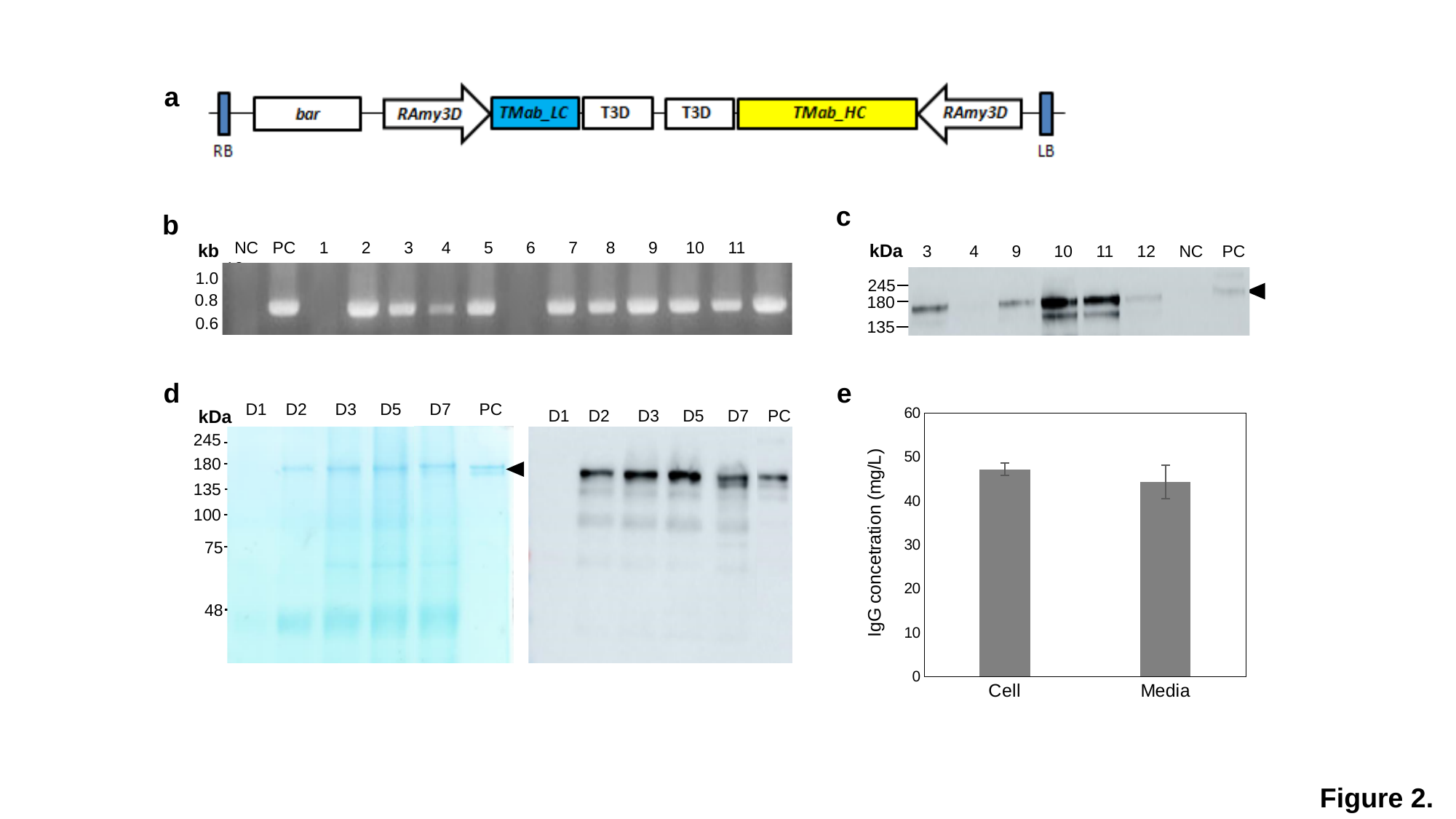
In the bar chart in panel e, how many categories are plotted on the x axis? 2 In the bar chart in panel e, is the value for Cell greater or less than 50? less In the bar chart in panel e, is the value for Cell greater or less than 40? greater In the bar chart in panel e, is the value for Media greater or less than 40? greater In the bar chart in panel e, what is the label on the y axis? IgG concetration (mg/L) In the bar chart in panel e, which category has the taller bar, Cell or Media? Cell In panel e, what kind of chart is shown? bar chart In the bar chart in panel e, what is the highest value shown on the y axis? 60